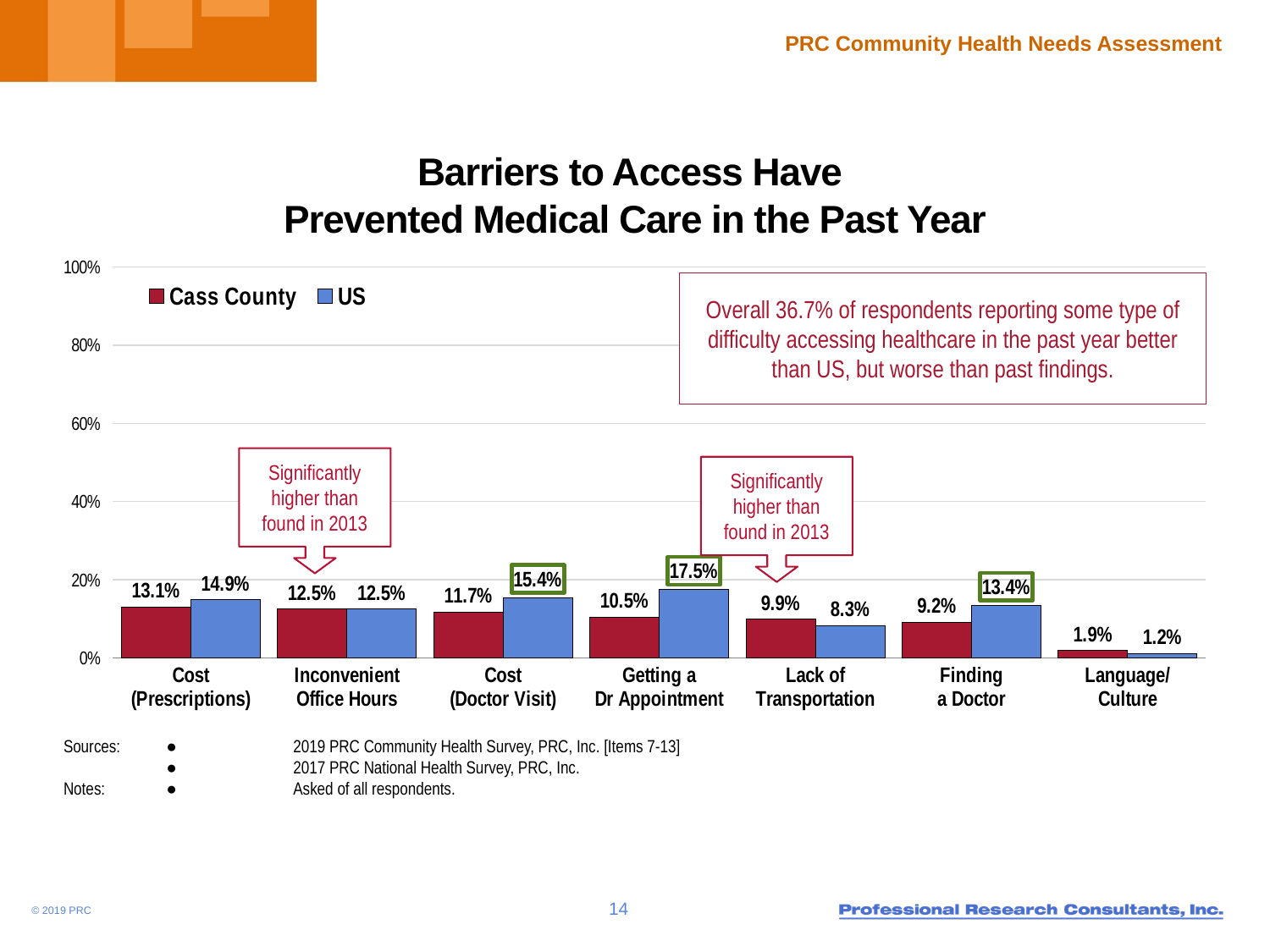
Which category has the highest Cass County value? Cost (Prescriptions) How many categories are shown on the x axis? 7 What is the Cass County value for Cost (Prescriptions)? 13.1% Which is larger for Lack of Transportation, the Cass County value or the US value? Cass County What is the difference between the US and Cass County values for Finding a Doctor? 4.2% What kind of chart is shown on the slide? bar chart What is the Cass County value for Lack of Transportation? 9.9% Which category has the lowest US value? Language/Culture What colour are the Cass County bars? red How many series does the legend list? 2 What is the US value for Getting a Dr Appointment? 17.5% Is the US value for Cost (Doctor Visit) greater or less than 20%? less